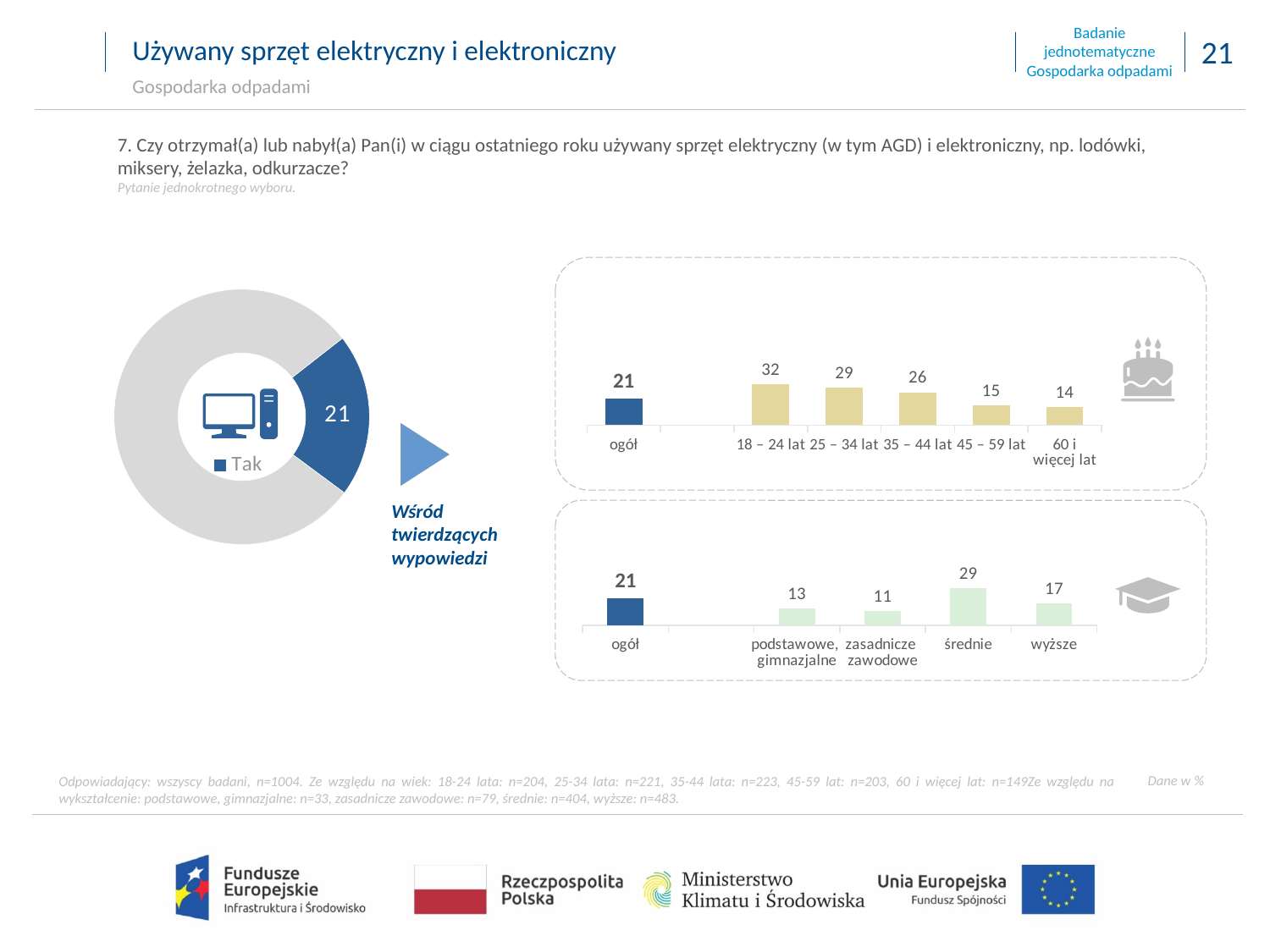
In the top-right bar chart by age, what is the value for 18 – 24 lat? 32 In the bottom-right bar chart by education, which education group has the lowest value? zasadnicze zawodowe What kind of chart is the chart on the left of the slide? doughnut chart In the bottom-right bar chart by education, which is larger, the value for wyższe or the value for podstawowe, gimnazjalne? wyższe In the top-right bar chart by age, which age group has the lowest value? 60 i więcej lat In the top-right bar chart by age, do the values rise or fall from 18 – 24 lat to 60 i więcej lat? fall In the top-right bar chart by age, how many bars are plotted, including ogół? 6 In the donut chart on the left, what value is shown for the "Tak" slice? 21 In the top-right bar chart by age, which age group has the highest value? 18 – 24 lat In the bottom-right bar chart by education, what is the value for średnie? 29 In the top-right bar chart by age, what is the difference between the values for 18 – 24 lat and 45 – 59 lat? 17 In the bottom-right bar chart by education, what is the difference between the values for średnie and zasadnicze zawodowe? 18